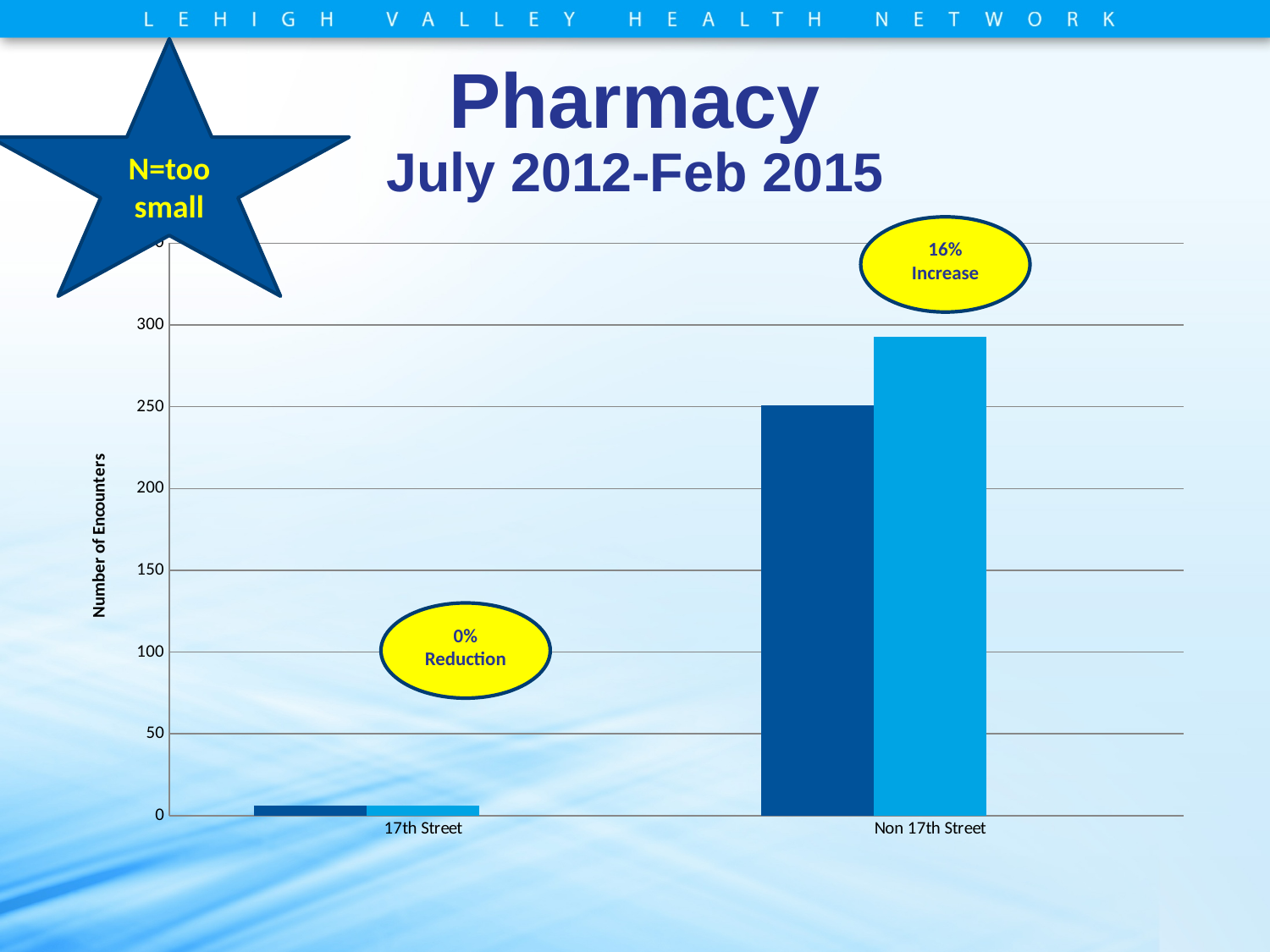
Is the value of the dark blue bar for Non 17th Street greater or less than 200? greater Are the bars for 17th Street greater or less than 50? less Which category has the highest number of encounters? Non 17th Street Is the value of the light blue bar for Non 17th Street greater or less than 250? greater How many categories are shown on the x axis of the chart? 2 What is the label of the y axis of the chart? Number of Encounters What kind of chart is shown on the slide? bar chart What percentage change is annotated above the Non 17th Street bars? 16% Increase For Non 17th Street, which bar is larger, the dark blue bar or the light blue bar? the light blue bar Which category has the lowest number of encounters? 17th Street How many bars are plotted for each category? 2